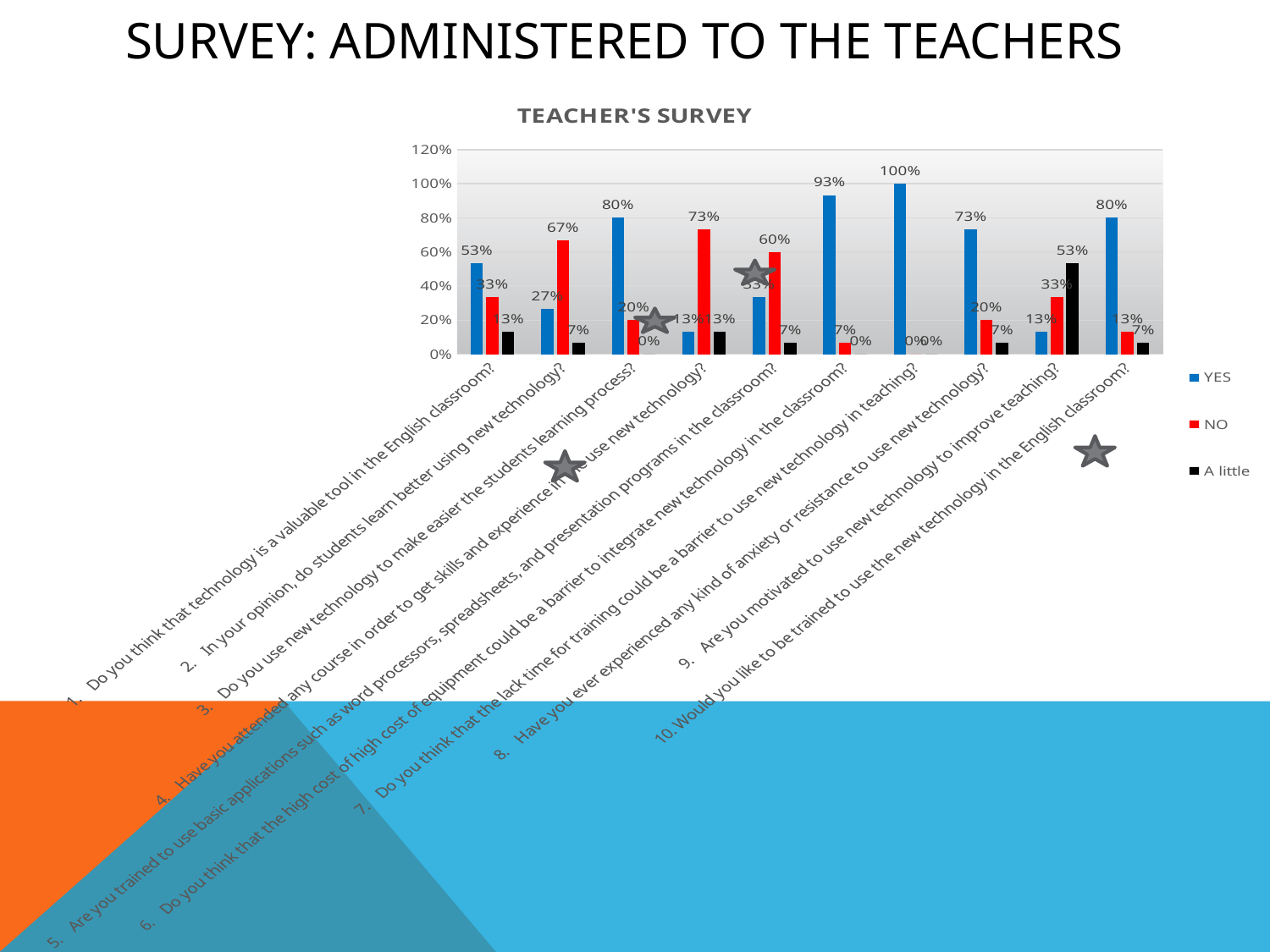
For question 6 (high cost of equipment as a barrier), which is larger, the YES value or the NO value? YES What is the NO value for question 2 (do students learn better using new technology)? 67% What is the title of the chart? TEACHER'S SURVEY What is the YES value for question 7 (lack of time for training as a barrier)? 100% What colour represents the NO series in the chart? red Which survey question has the highest YES value? 7. Do you think that the lack time for training could be a barrier to use new technology in teaching? What is the 'A little' value for question 9 (are you motivated to use new technology to improve teaching)? 53% How many series does the legend list? 3 What type of chart is shown on the slide? bar chart Which survey question has the highest NO value? 4. Have you attended any course in order to get skills and experience in the use new technology? How many survey questions (categories) are plotted on the x axis? 10 What is the difference between the YES and NO values for question 1 (technology is a valuable tool in the English classroom)? 20%